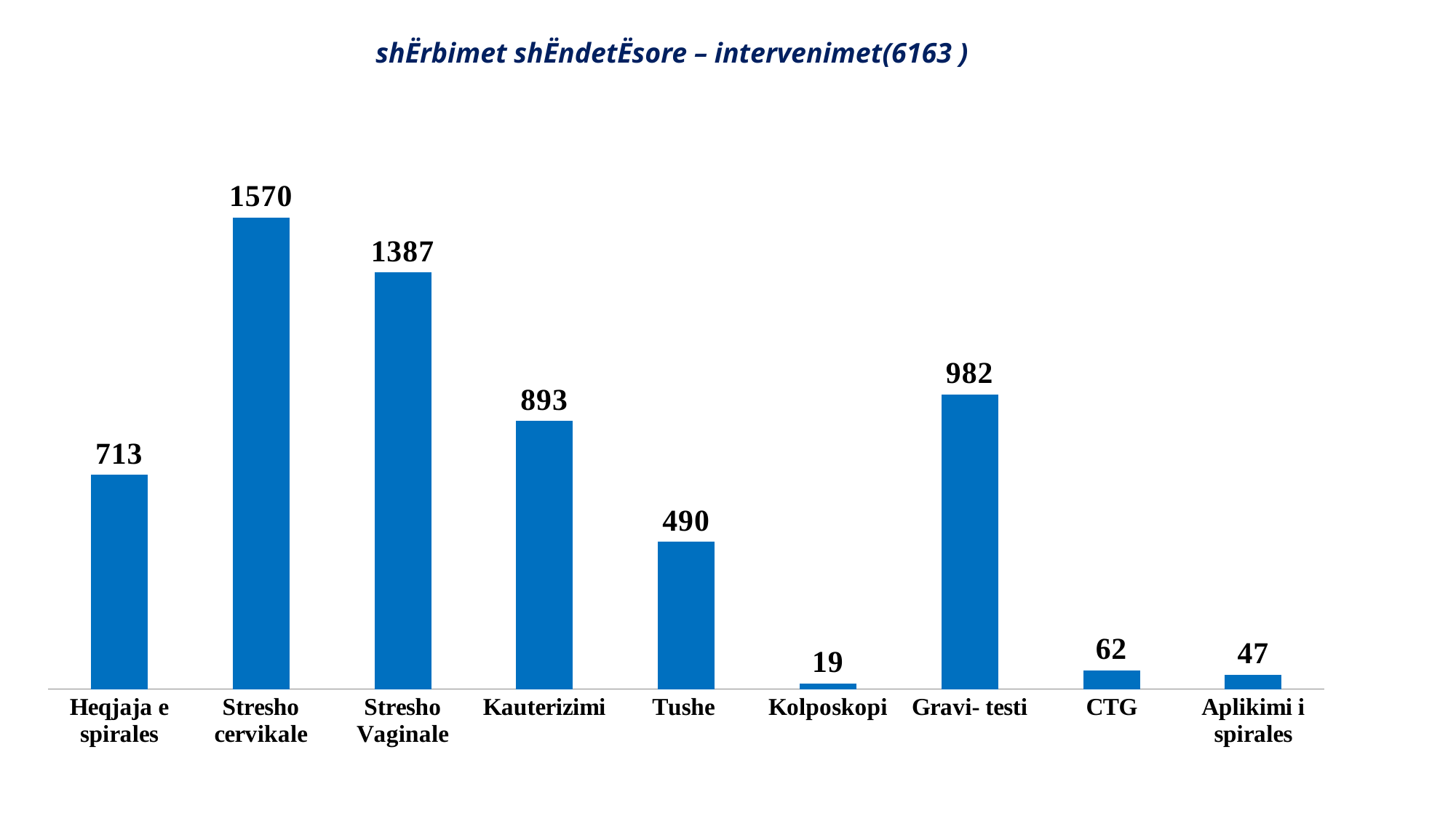
What is the value for Kauterizimi? 893 What kind of chart is shown on the slide? Bar chart What is the value for Stresho cervikale? 1570 Which is larger, the value for CTG or the value for Aplikimi i spirales? CTG Which category has the lowest value? Kolposkopi What is the difference between the values for Stresho cervikale and Stresho Vaginale? 183 Which category has the highest value? Stresho cervikale What is the difference between the values for Gravi- testi and Tushe? 492 What is the value for CTG? 62 Which is larger, the value for Heqjaja e spirales or the value for Gravi- testi? Gravi- testi How many categories are shown on the chart? 9 What is the title of the chart? shËrbimet shËndetËsore – intervenimet(6163 )